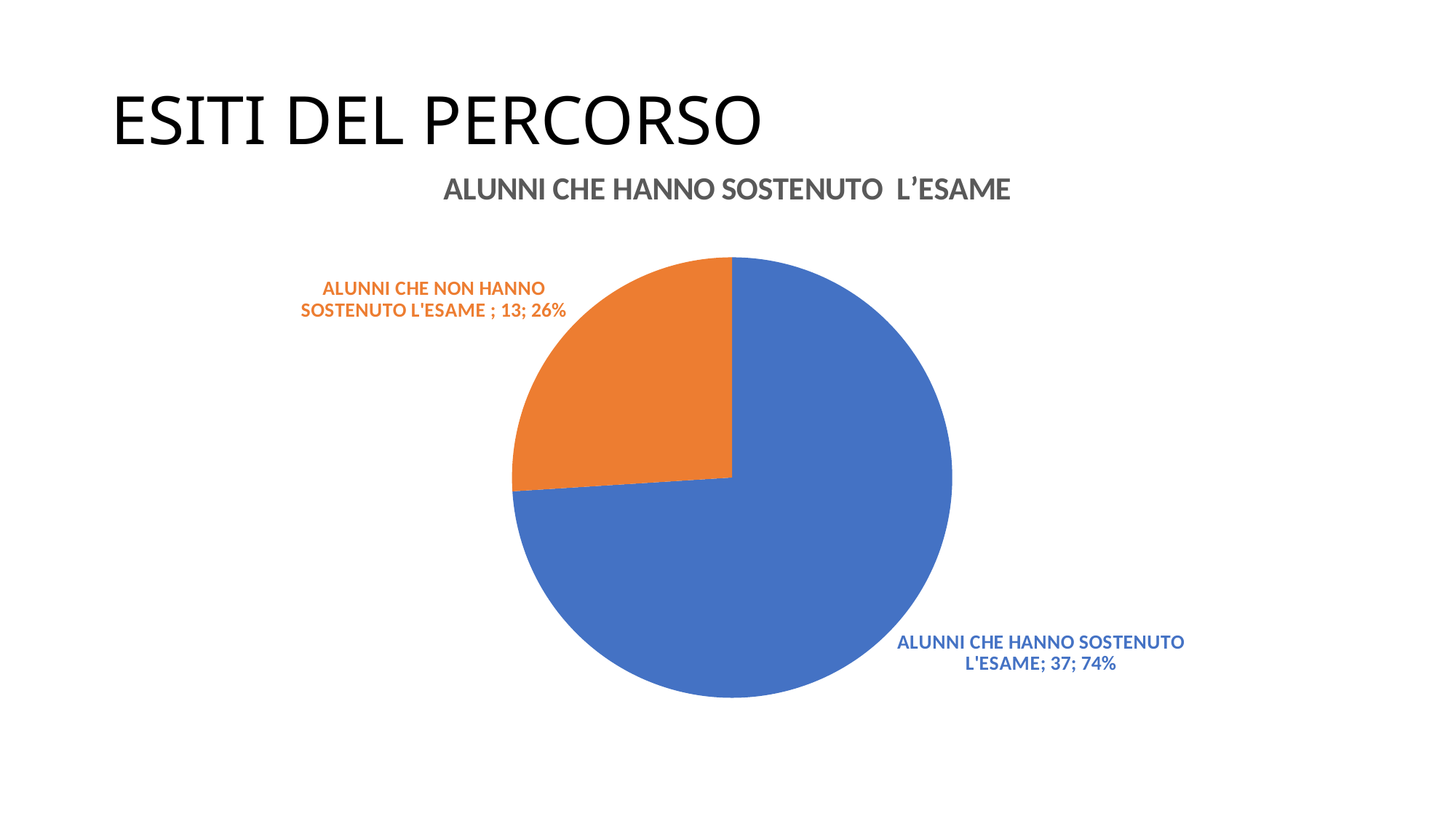
What is the title of the chart? ALUNNI CHE HANNO SOSTENUTO L'ESAME What is the total number of students represented in the pie chart? 50 What is the difference in number of students between the 'ALUNNI CHE HANNO SOSTENUTO L'ESAME' slice and the 'ALUNNI CHE NON HANNO SOSTENUTO L'ESAME' slice? 24 Which slice is the smallest? ALUNNI CHE NON HANNO SOSTENUTO L'ESAME How many slices does the pie chart have? 2 What kind of chart is shown on the slide? pie chart What share of the pie does 'ALUNNI CHE NON HANNO SOSTENUTO L'ESAME' represent? 26% What colour is the 'ALUNNI CHE NON HANNO SOSTENUTO L'ESAME' slice? orange How many students are in the 'ALUNNI CHE HANNO SOSTENUTO L'ESAME' slice? 37 Which slice is the largest? ALUNNI CHE HANNO SOSTENUTO L'ESAME What share of the pie does 'ALUNNI CHE HANNO SOSTENUTO L'ESAME' represent? 74% How many students are in the 'ALUNNI CHE NON HANNO SOSTENUTO L'ESAME' slice? 13